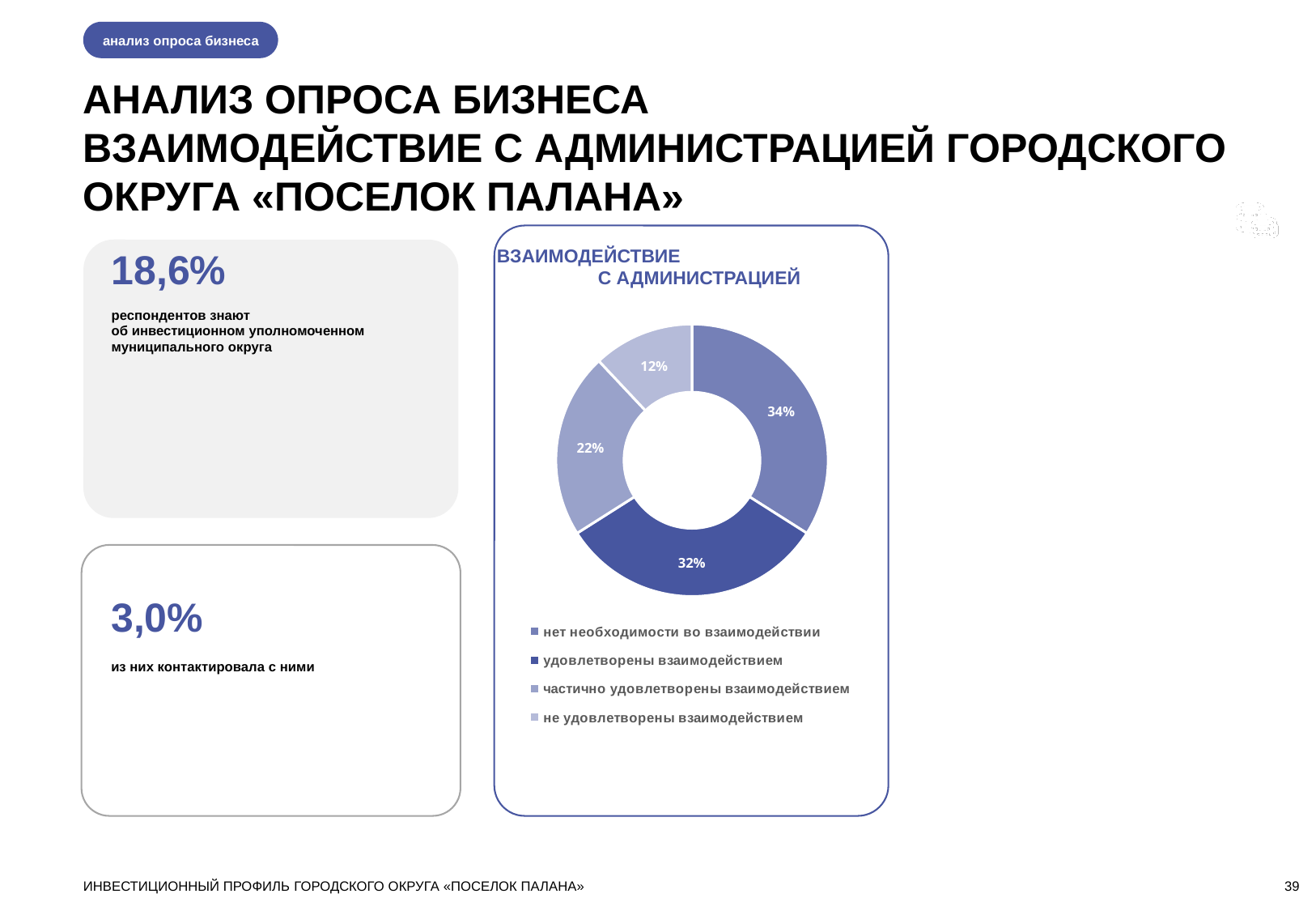
What is the title of the chart? ВЗАИМОДЕЙСТВИЕ С АДМИНИСТРАЦИЕЙ What kind of chart is shown on the slide? Donut (pie) chart What share of respondents answered «частично удовлетворены взаимодействием»? 22% What share of respondents answered «удовлетворены взаимодействием»? 32% Which is larger: the share for «удовлетворены взаимодействием» or for «частично удовлетворены взаимодействием»? удовлетворены взаимодействием How many categories does the chart's legend list? 4 What is the combined share of «удовлетворены взаимодействием» and «частично удовлетворены взаимодействием»? 54% What share of respondents answered «не удовлетворены взаимодействием»? 12% Which category has the largest share in the chart? нет необходимости во взаимодействии Which category has the smallest share in the chart? не удовлетворены взаимодействием What is the difference between the shares for «частично удовлетворены взаимодействием» and «не удовлетворены взаимодействием»? 10% What share of respondents answered «нет необходимости во взаимодействии»? 34%